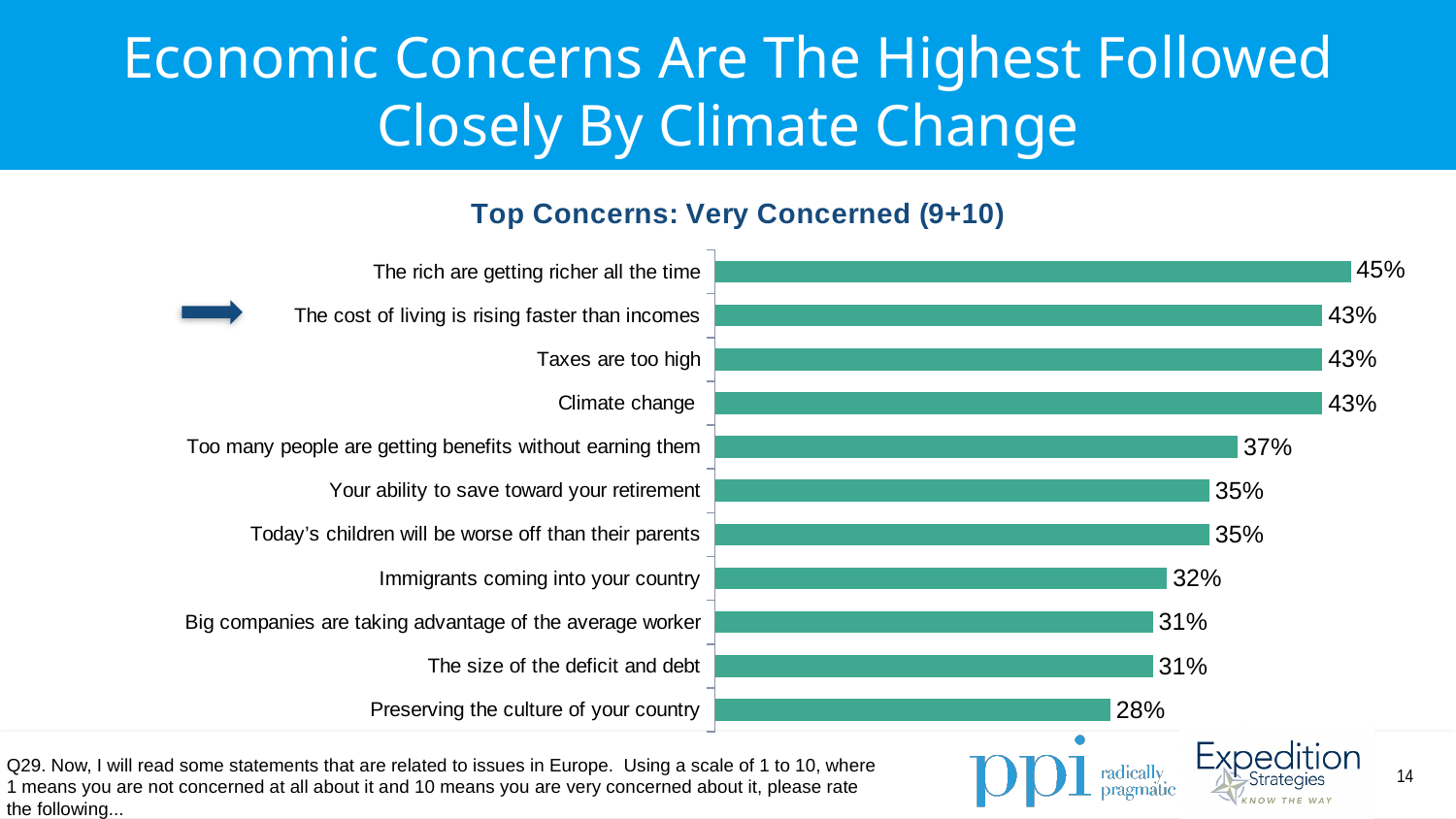
What percentage is shown for 'Preserving the culture of your country'? 28% What is the value shown for 'Climate change'? 43% Which concern has the highest percentage of very concerned respondents? The rich are getting richer all the time What is the difference between 'Too many people are getting benefits without earning them' and 'Your ability to save toward your retirement'? 2 percentage points What type of chart is shown on the slide? Bar chart Which concern has the lowest percentage? Preserving the culture of your country What is the difference between 'The rich are getting richer all the time' and 'Preserving the culture of your country'? 17 percentage points What is the value for 'Immigrants coming into your country'? 32% How many concerns are listed in the chart? 11 Which is larger: the value for 'Taxes are too high' or the value for 'The size of the deficit and debt'? Taxes are too high What is the title of the chart? Top Concerns: Very Concerned (9+10) What percentage of respondents are very concerned that the rich are getting richer all the time? 45%